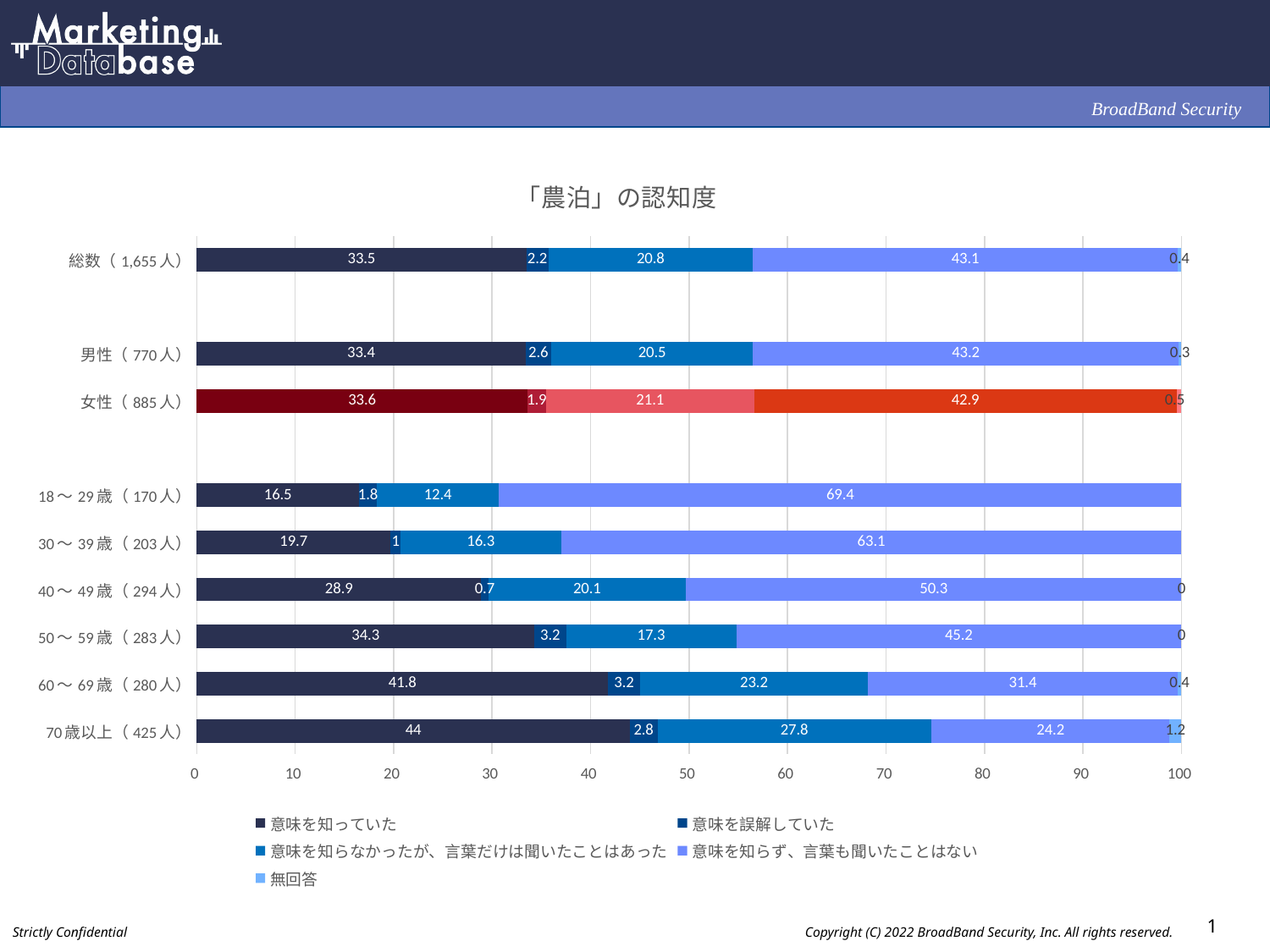
Which age group has the highest value for 意味を知っていた? 70歳以上 (425人) What type of chart is shown on the slide? Stacked bar chart What is the value of 意味を知らなかったが、言葉だけは聞いたことはあった for 70歳以上 (425人)? 27.8 What is the value of 意味を知っていた for 総数 (1,655人)? 33.5 What is the value of 意味を知らず、言葉も聞いたことはない for 18〜29歳 (170人)? 69.4 Which is larger, the 意味を知らず、言葉も聞いたことはない value for 30〜39歳 (203人) or for 60〜69歳 (280人)? 30〜39歳 (203人) How many series does the legend list? 5 What is the difference between the 意味を知っていた values for 男性 (770人) and 女性 (885人)? 0.2 Does the value of 意味を知っていた generally rise or fall as the age groups go from 18〜29歳 to 70歳以上? Rise Which age group has the lowest value for 意味を知っていた? 18〜29歳 (170人) How many categories (bars) are plotted in the chart? 9 What is the title of the chart? 「農泊」の認知度